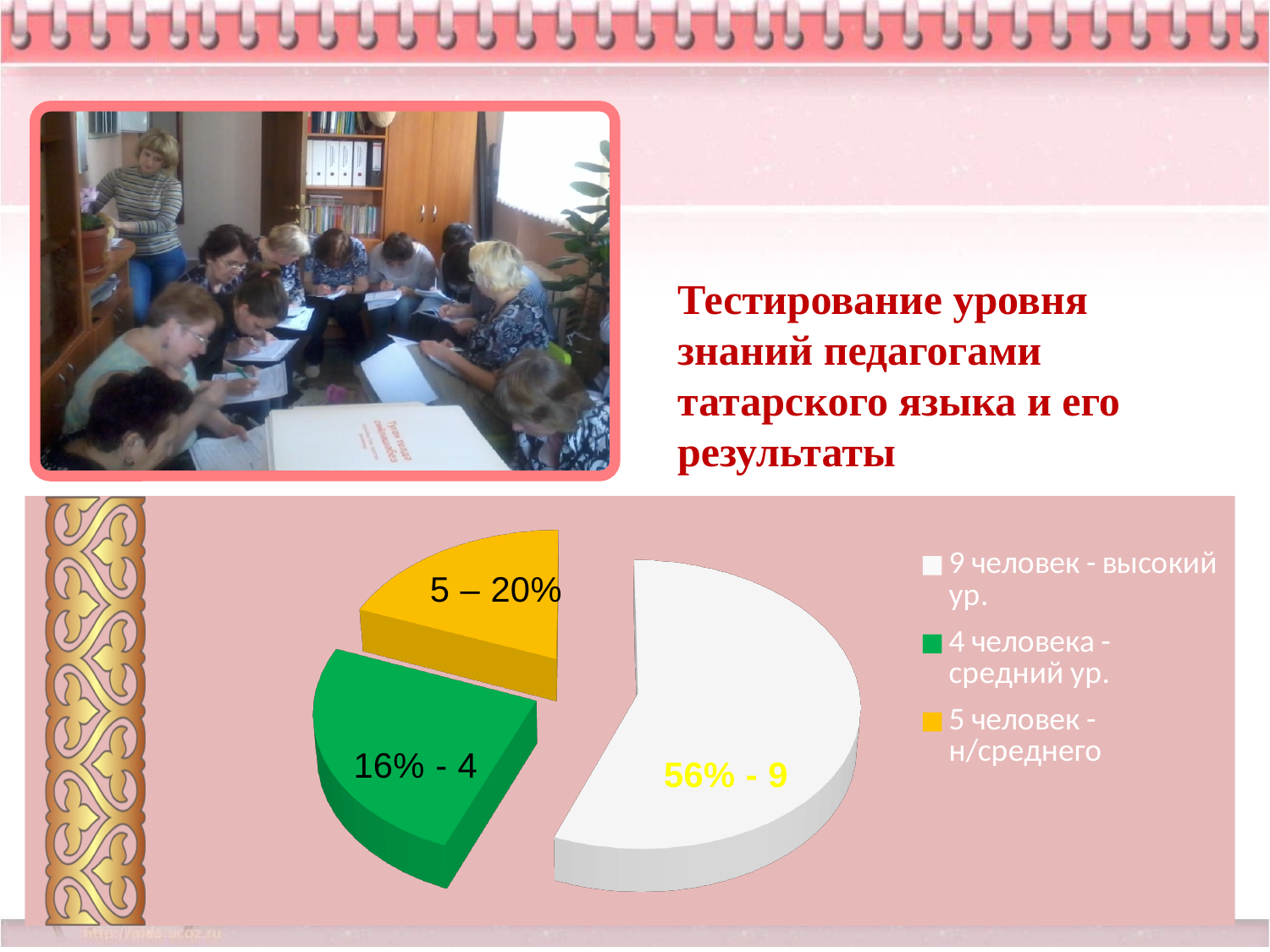
What colour is the slice for "4 человека - средний ур." in the pie chart? green What colour is the slice for "5 человек - н/среднего" in the pie chart? yellow What percentage is shown on the slice for "4 человека - средний ур."? 16% What kind of chart is shown on the slide? pie chart How many entries does the legend of the pie chart list? 3 What percentage is shown on the slice for "5 человек - н/среднего"? 20% What percentage is shown on the slice for "9 человек - высокий ур."? 56% How many slices does the pie chart have? 3 Which legend category has the largest slice of the pie chart? 9 человек - высокий ур. What is the difference in percentage points between the "9 человек - высокий ур." slice and the "5 человек - н/среднего" slice? 36